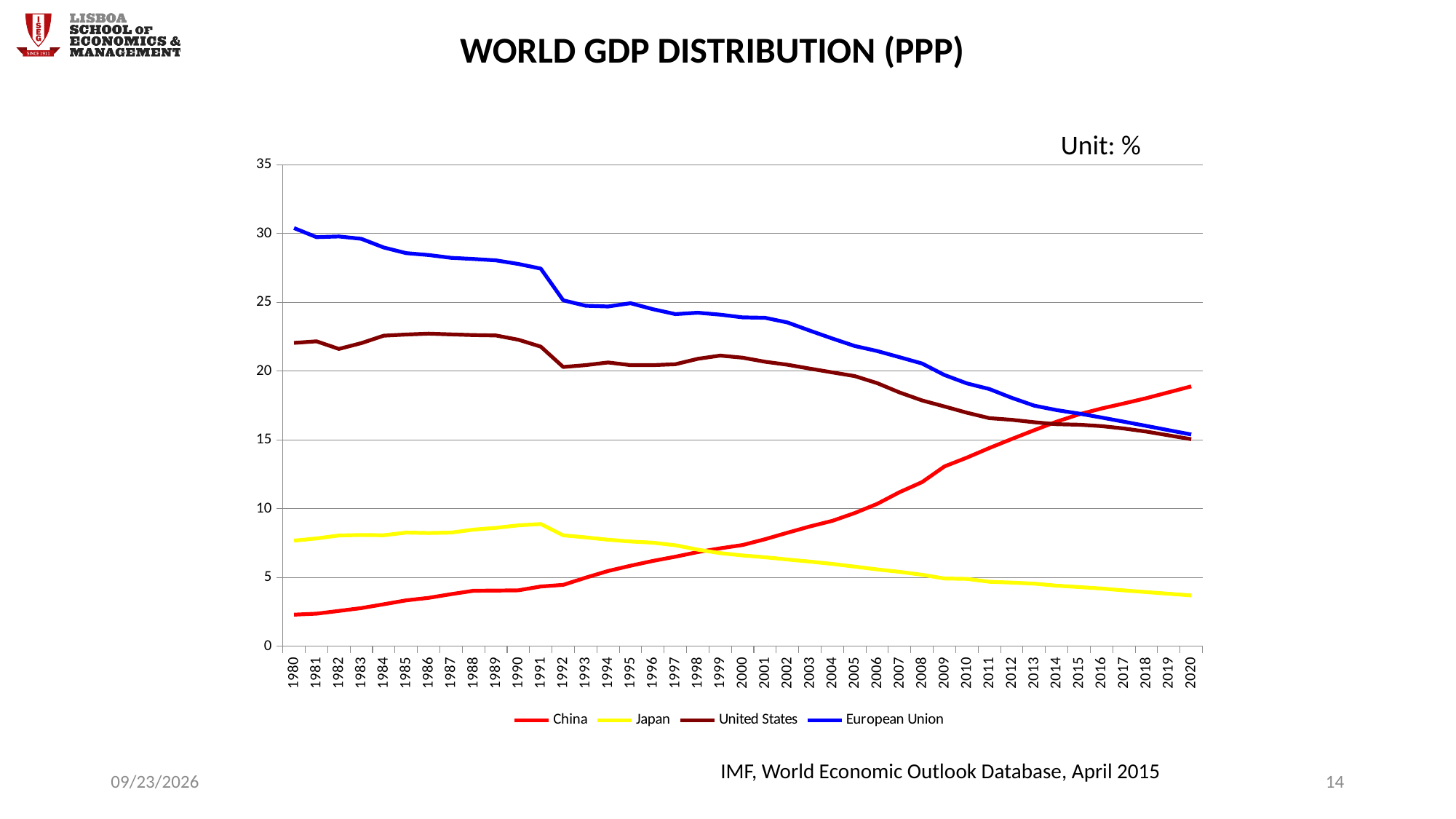
Which series has the lowest value in 2020? Japan Which series has the highest value in 1980? European Union How many years are shown along the x axis? 41 What kind of chart is shown on the slide? line chart In 2020, which is larger, the value for China or the value for the United States? China Is the value for China in 1980 greater or less than 5? less What unit is stated for the values in the chart? % Does the value for the European Union rise or fall from 1980 to 2020? fall How many series does the legend list? 4 Does the value for China rise or fall from 1980 to 2020? rise Which series has the highest value in 2020? China Is the value for Japan in 2020 greater or less than 5? less